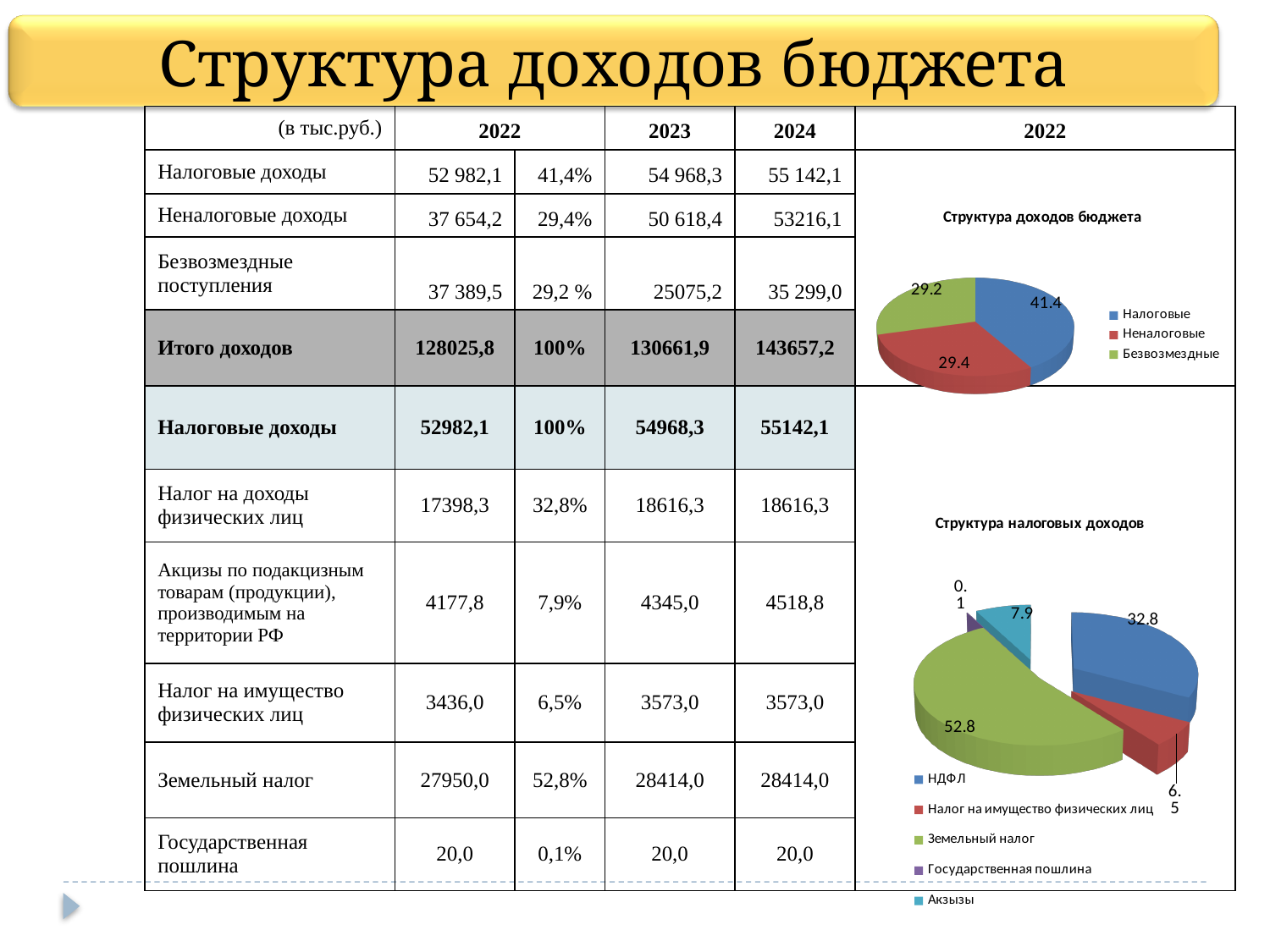
In the chart titled «Структура налоговых доходов», which is larger: «НДФЛ» or «Налог на имущество физических лиц»? НДФЛ In the chart titled «Структура налоговых доходов», what is the value shown for the «Акзызы» slice? 7.9 In the chart titled «Структура налоговых доходов», which category has the smallest slice? Государственная пошлина In the chart titled «Структура доходов бюджета», which category has the largest slice? Налоговые In the chart titled «Структура доходов бюджета», how many slices does the pie have? 3 In the chart titled «Структура доходов бюджета», what is the value shown for the «Неналоговые» slice? 29.4 In the chart titled «Структура налоговых доходов», what is the difference between the «Земельный налог» and «НДФЛ» values? 20.0 How many entries does the legend of the chart «Структура налоговых доходов» list? 5 In the chart titled «Структура доходов бюджета», what is the value shown for the «Налоговые» slice? 41.4 In the chart titled «Структура налоговых доходов», what is the value shown for the «НДФЛ» slice? 32.8 What kind of chart is «Структура доходов бюджета»? Pie chart In the chart titled «Структура налоговых доходов», what is the value shown for the «Земельный налог» slice? 52.8